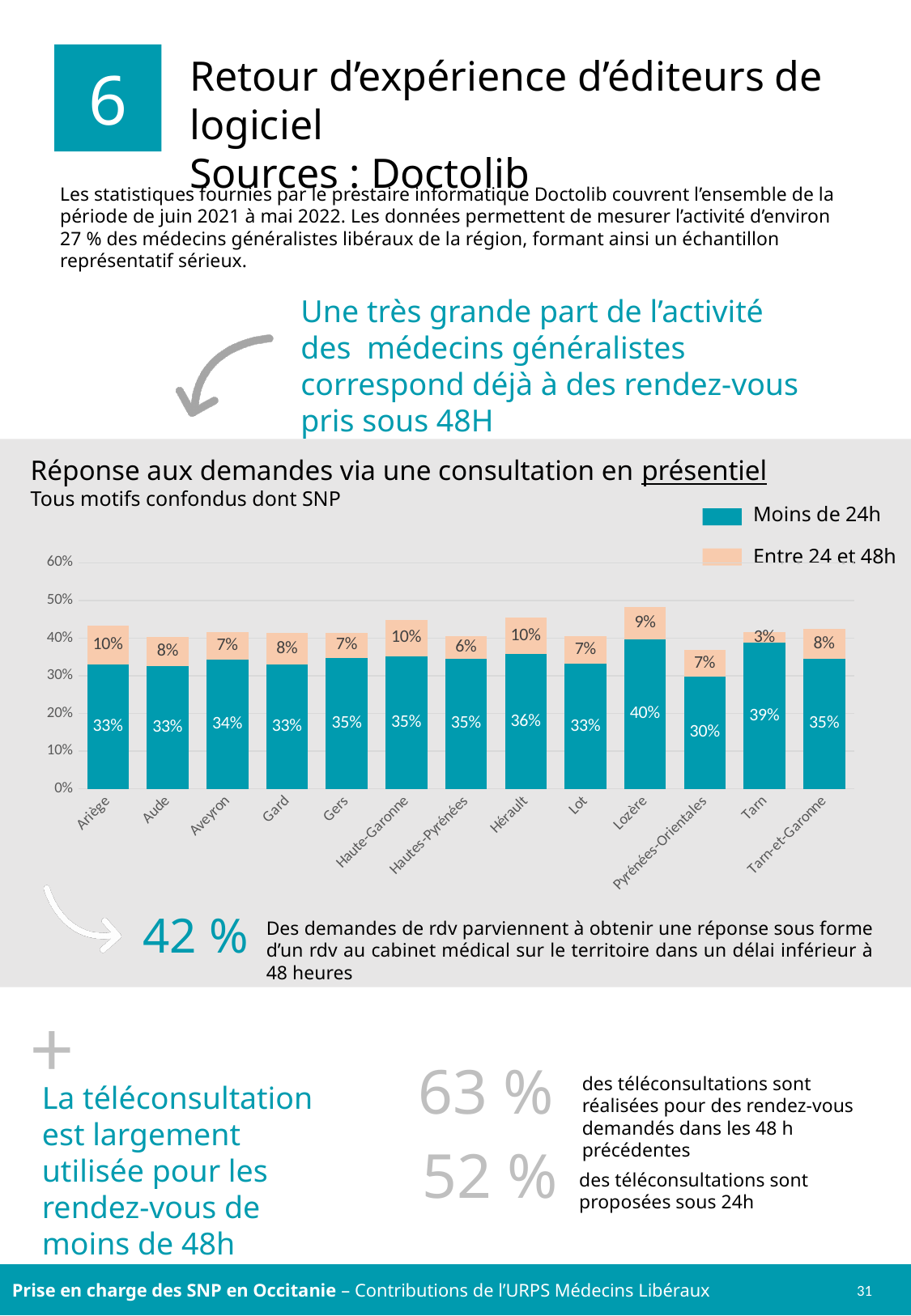
What is the 'Moins de 24h' value for Pyrénées-Orientales? 30% Which department has the lowest 'Entre 24 et 48h' value? Tarn Which department has the highest 'Moins de 24h' value? Lozère What is the difference between the 'Moins de 24h' values for Lozère and Pyrénées-Orientales? 10% What is the total of the stacked bar for Lozère? 49% Which has a larger 'Moins de 24h' value, Tarn or Aude? Tarn Which department has the lowest 'Moins de 24h' value? Pyrénées-Orientales What kind of chart is shown on the slide? Stacked bar chart What is the 'Entre 24 et 48h' value for Tarn? 3% How many series does the chart legend list? 2 How many departments are shown on the x axis of the chart? 13 What is the 'Moins de 24h' value for Lozère? 40%